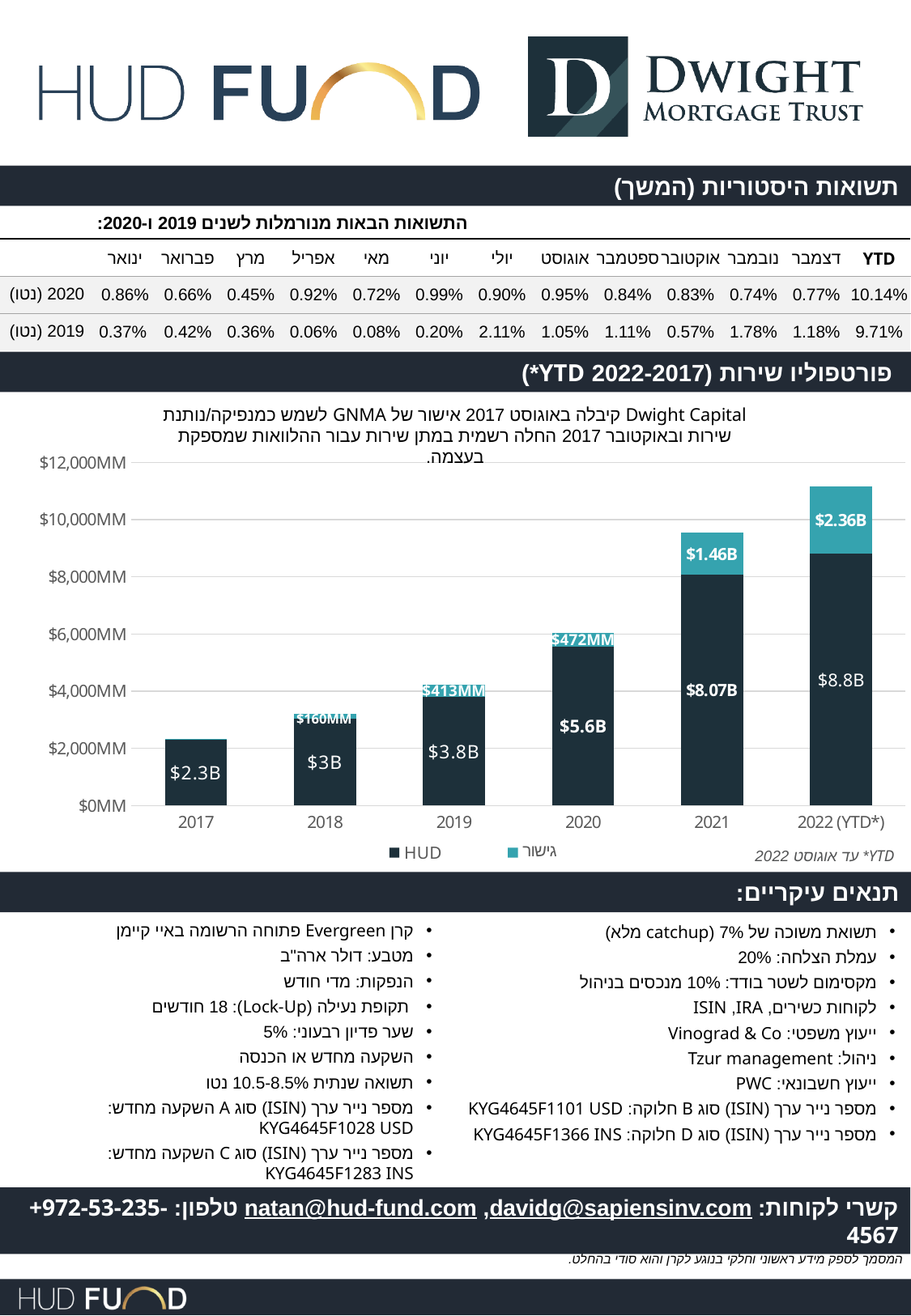
What is the HUD value for 2020? $5.6B What is the difference between the HUD values for 2021 and 2020? $2.47B Which year has the lowest HUD value? 2017 Which is larger, the גישור value for 2021 or for 2020? 2021 What type of chart is shown on the slide? stacked bar chart What is the total of the stacked bar for 2021? $9.53B What is the גישור value for 2022 (YTD*)? $2.36B How many series does the legend list? 2 Which year has the highest HUD value? 2022 (YTD*) What is the HUD value for 2017? $2.3B What is the גישור value for 2019? $413MM How many years are shown on the x axis? 6